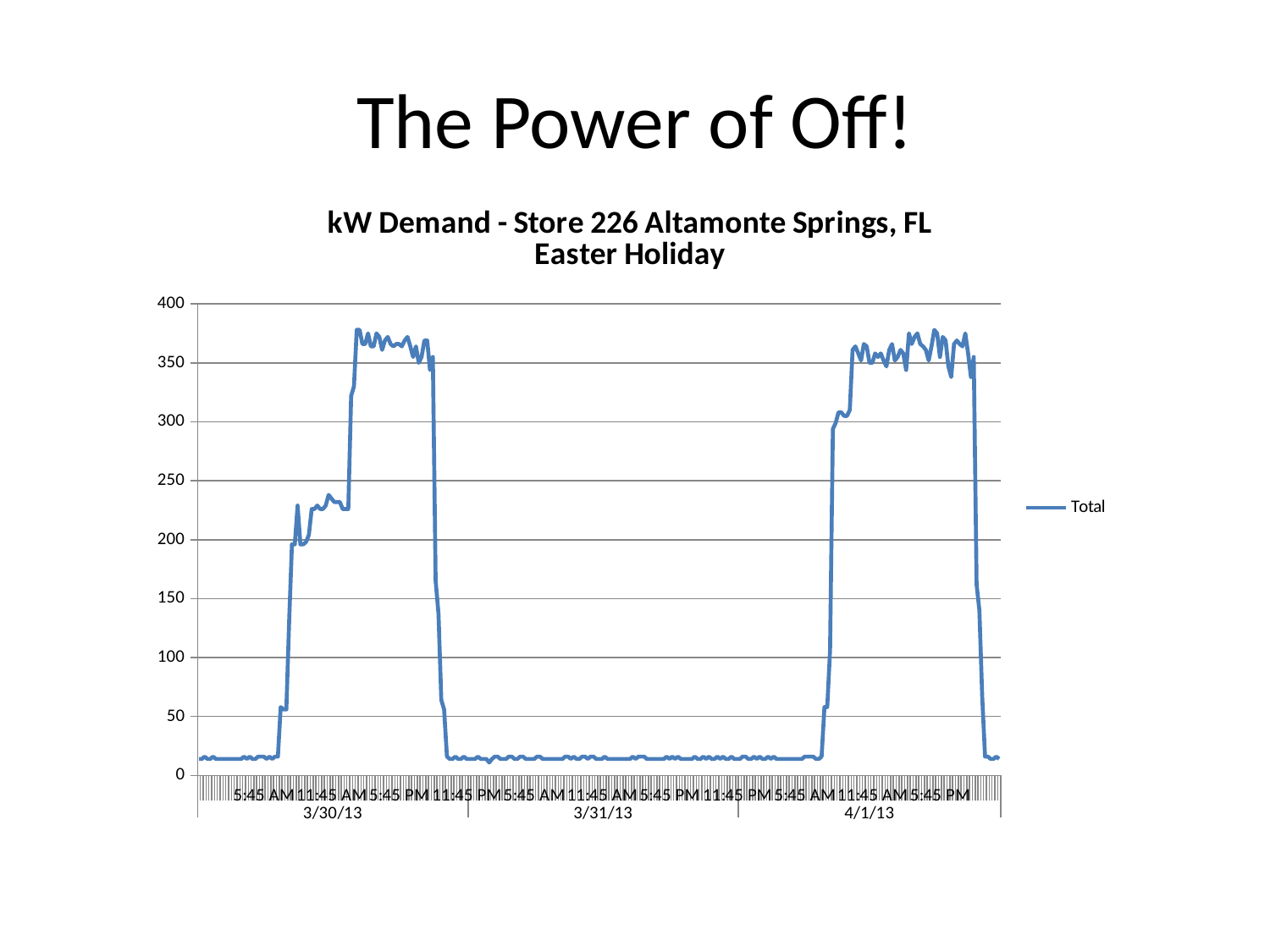
Which is larger, the Total at 11:45 AM on 3/30/13 or the Total at 11:45 AM on 3/31/13? 11:45 AM on 3/30/13 What is the name of the series shown in the legend? Total What kind of chart is shown on the slide? line chart How many series does the legend list? 1 On which of the three dates does the Total stay lowest throughout the day? 3/31/13 Is the value for Total at 5:45 PM on 4/1/13 greater or less than 300? greater What is the title of the chart? kW Demand - Store 226 Altamonte Springs, FL Easter Holiday How many dates are labelled along the x axis? 3 Is the value for Total at 5:45 PM on 3/30/13 greater or less than 350? greater Is the value for Total at 11:45 PM on 3/30/13 greater or less than 50? less What is the highest value shown on the y axis? 400